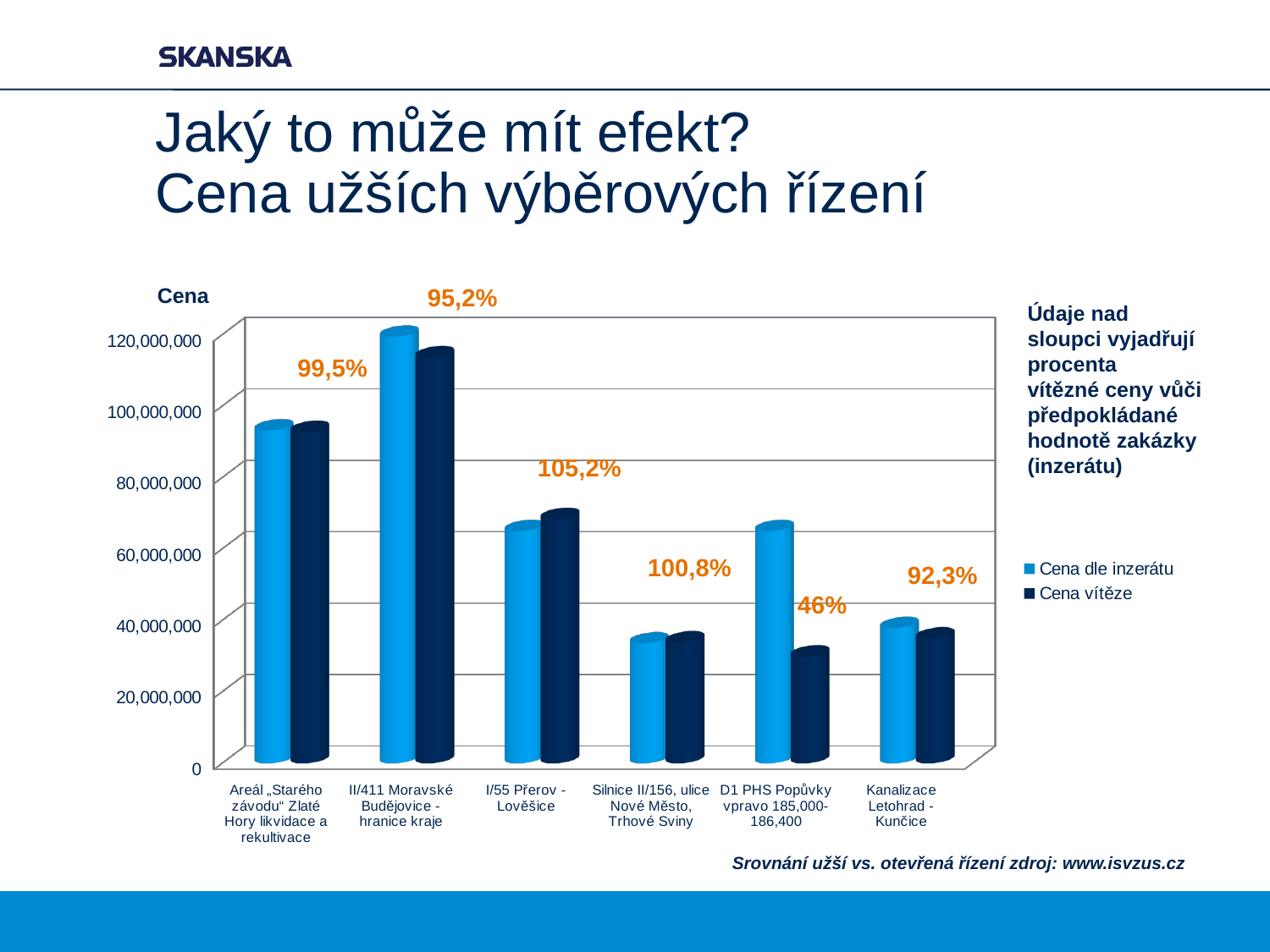
Is the Cena vítěze value for Areál „Starého závodu“ Zlaté Hory likvidace a rekultivace greater or less than 80,000,000? greater Is the Cena dle inzerátu value for II/411 Moravské Budějovice - hranice kraje greater or less than 100,000,000? greater Is the Cena vítěze value for D1 PHS Popůvky vpravo 185,000-186,400 greater or less than 40,000,000? less How many project categories are shown on the x axis of the chart? 6 Which category has the lowest value for Cena dle inzerátu? Silnice II/156, ulice Nové Město, Trhové Sviny What are the two series names listed in the chart legend? Cena dle inzerátu, Cena vítěze How many series does the chart legend list? 2 For D1 PHS Popůvky vpravo 185,000-186,400, which is larger: Cena dle inzerátu or Cena vítěze? Cena dle inzerátu Which category has the highest value for Cena dle inzerátu? II/411 Moravské Budějovice - hranice kraje Which category has the highest value for Cena vítěze? II/411 Moravské Budějovice - hranice kraje What kind of chart is shown on the slide? bar chart What percentage is printed above the bars for D1 PHS Popůvky vpravo 185,000-186,400? 46%